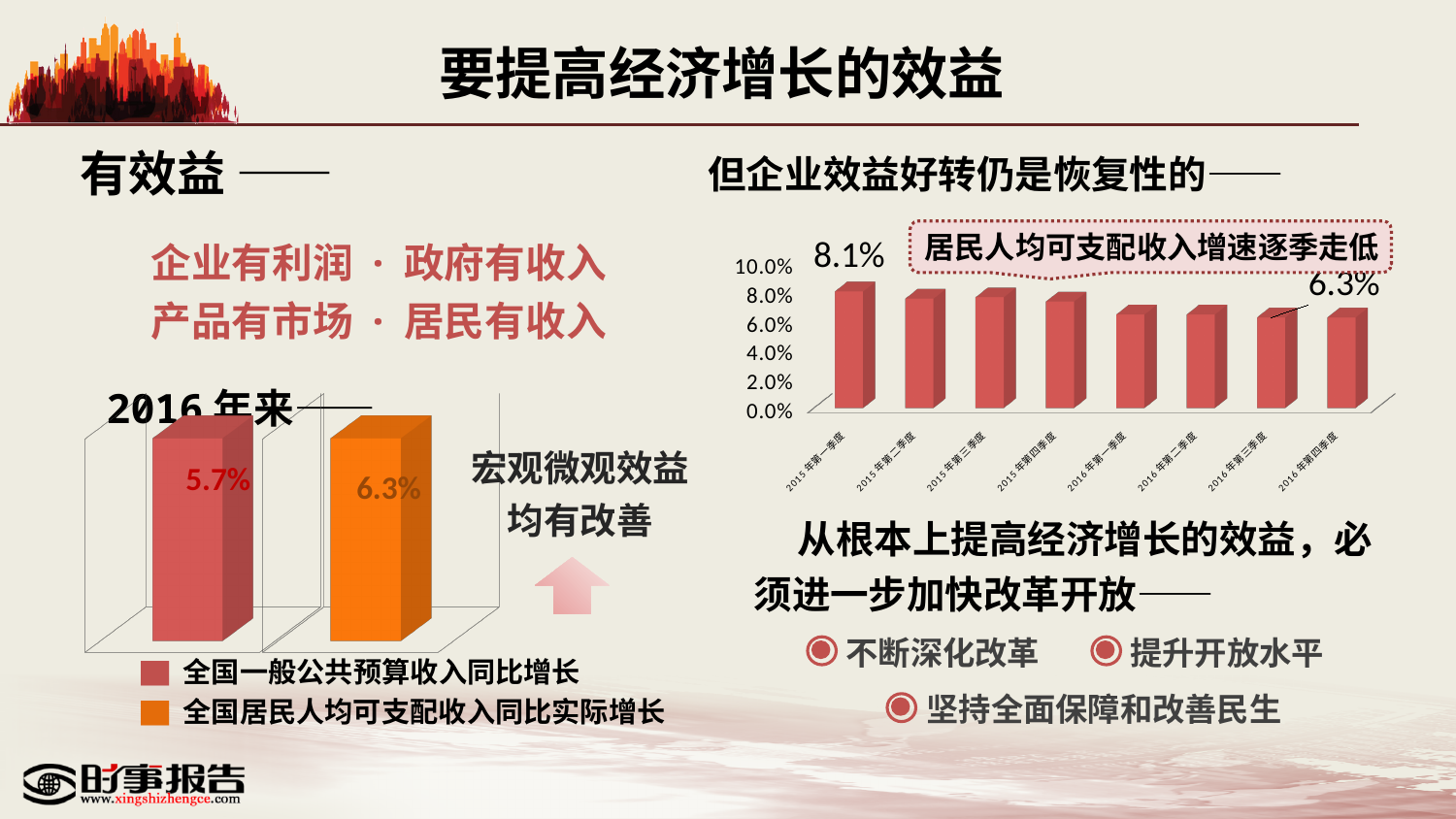
On the left chart (2016年来), what is the difference between the two bar values? 0.6% On the right chart (居民人均可支配收入增速逐季走低), is the value for 2016年第一季度 greater or less than 8.0%? less On the right chart (居民人均可支配收入增速逐季走低), what is the value for 2016年第四季度? 6.3% On the left chart (2016年来), what is the value for 全国一般公共预算收入同比增长? 5.7% What kind of chart is the left chart (2016年来)? bar chart On the right chart (居民人均可支配收入增速逐季走低), do the values rise or fall from 2015年第一季度 to 2016年第四季度? fall On the left chart (2016年来), how many series does the legend list? 2 On the left chart (2016年来), which series has the larger value, 全国一般公共预算收入同比增长 or 全国居民人均可支配收入同比实际增长? 全国居民人均可支配收入同比实际增长 On the right chart (居民人均可支配收入增速逐季走低), what is the value for 2015年第一季度? 8.1% On the left chart (2016年来), what is the value for 全国居民人均可支配收入同比实际增长? 6.3% On the right chart (居民人均可支配收入增速逐季走低), which quarter has the highest value? 2015年第一季度 On the right chart (居民人均可支配收入增速逐季走低), how many quarters are plotted? 8